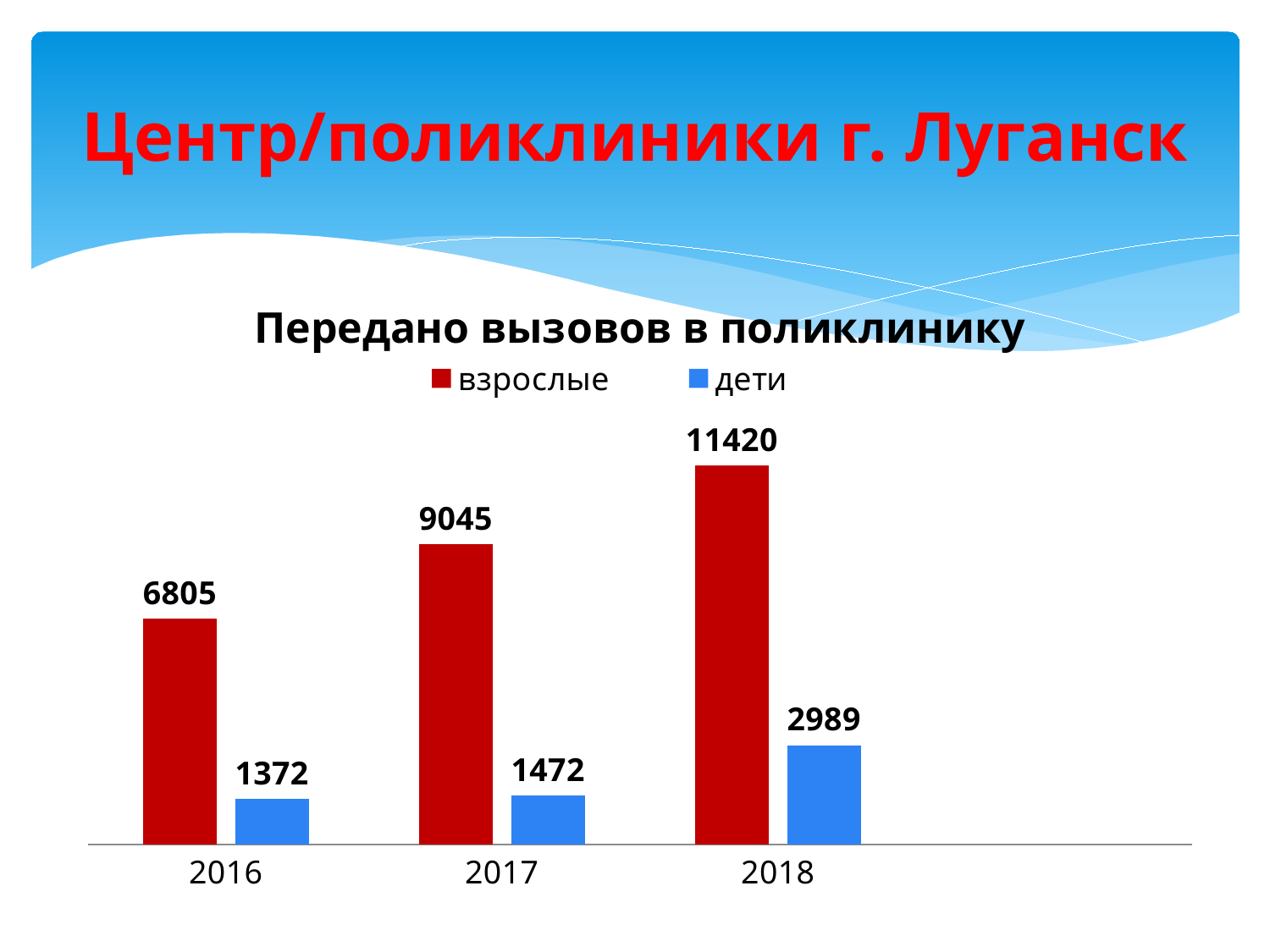
What is the difference between взрослые and дети in 2018? 8431 What is the value for взрослые in 2017? 9045 Which is larger: дети in 2018 or дети in 2017? дети in 2018 In which year is the value for дети lowest? 2016 What is the value for взрослые in 2016? 6805 How many series does the legend list? 2 In which year is the value for взрослые highest? 2018 What kind of chart is shown? bar chart How many years are shown on the x axis? 3 Do the values for взрослые rise or fall from 2016 to 2018? rise What is the difference between the дети values for 2017 and 2016? 100 What is the value for дети in 2018? 2989